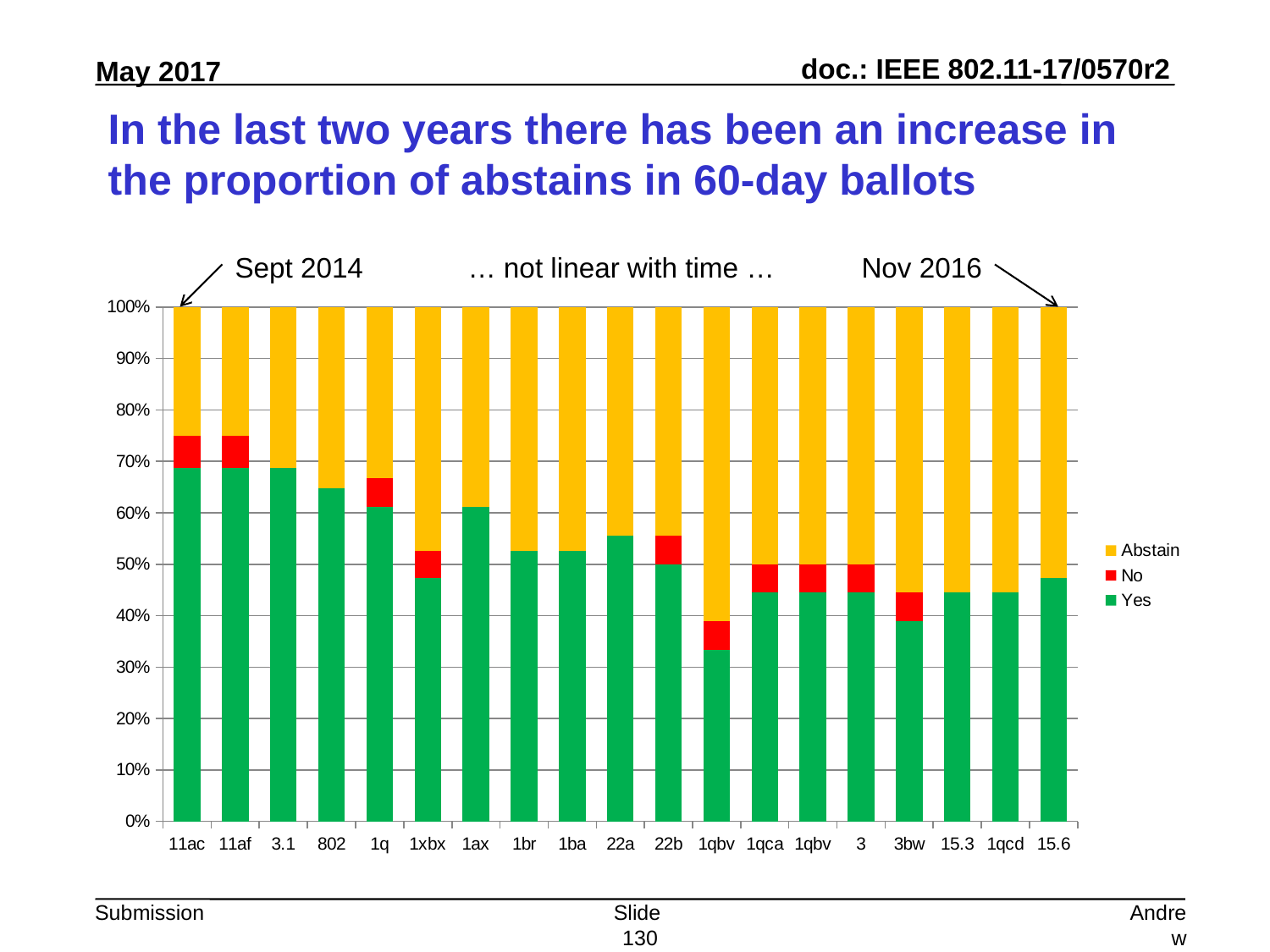
Which category has the lowest Yes share? 1qbv Is the Yes value for 15.6 greater or less than 50%? less Which has the larger Yes share, 1q or 1qca? 1q What is the total of the stacked bar for 11ac? 100% What kind of chart is shown on the slide? stacked bar chart Is the Yes value for 11ac greater or less than 60%? greater Does the Yes share generally rise or fall moving from left to right along the x axis? fall How many series does the legend list? 3 Is the Yes value for 1qbv (the first of the two 1qbv bars) greater or less than 40%? less How many categories are shown along the x axis? 19 Which colour represents the Abstain series in the legend? yellow